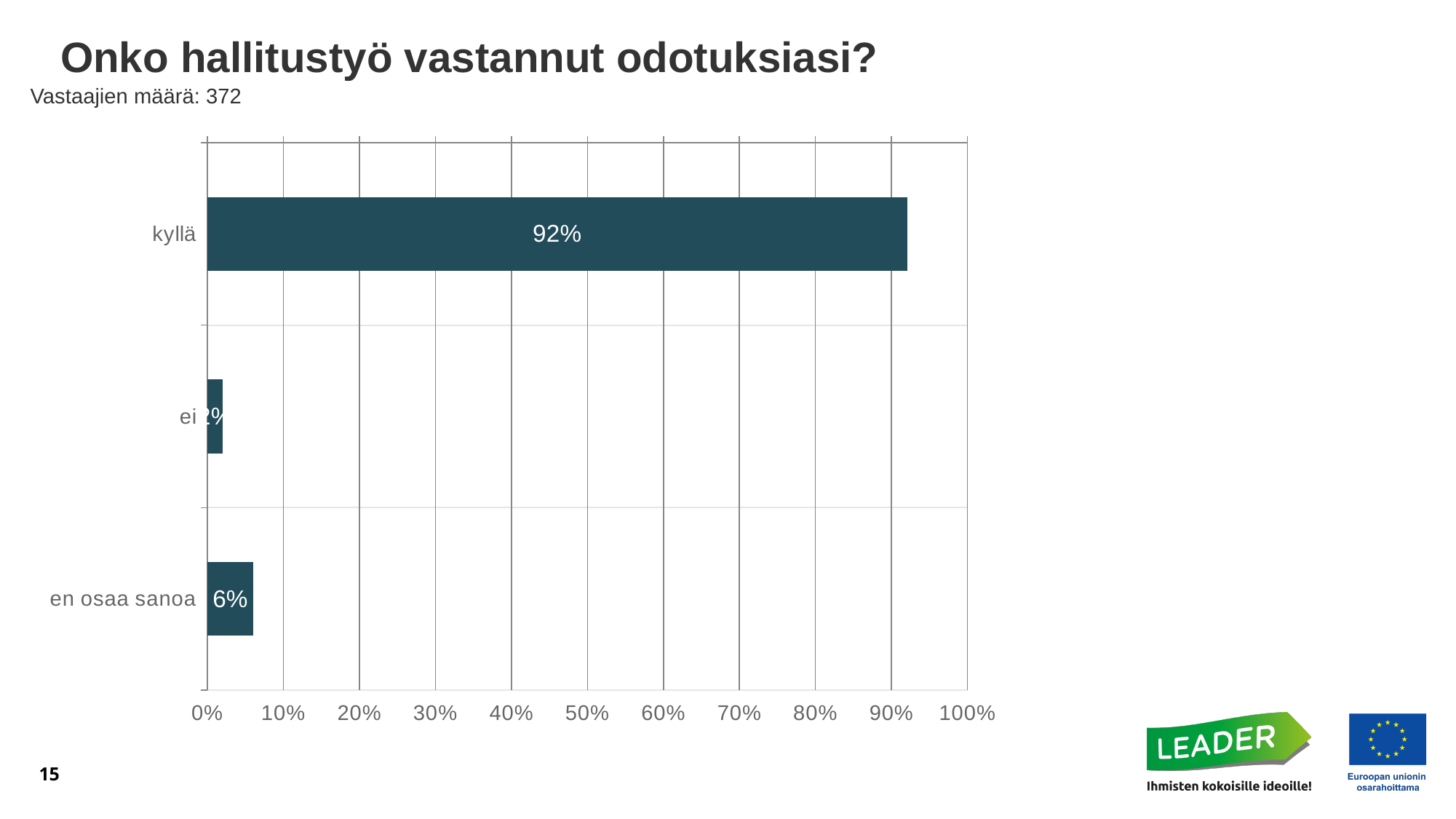
What is the value for "kyllä"? 92% Is the value for "ei" greater or less than 10%? less Which category has the lowest value? ei Which is larger, the value for "en osaa sanoa" or the value for "ei"? en osaa sanoa Which category has the highest value? kyllä What is the title of the slide containing the chart? Onko hallitustyö vastannut odotuksiasi? What kind of chart is shown on the slide? bar chart What is the value for "en osaa sanoa"? 6% What is the difference between the value for "kyllä" and the value for "en osaa sanoa"? 86 percentage points How many respondents (Vastaajien määrä) does the slide report? 372 Is the value for "kyllä" greater or less than 90%? greater How many categories are shown in the chart? 3